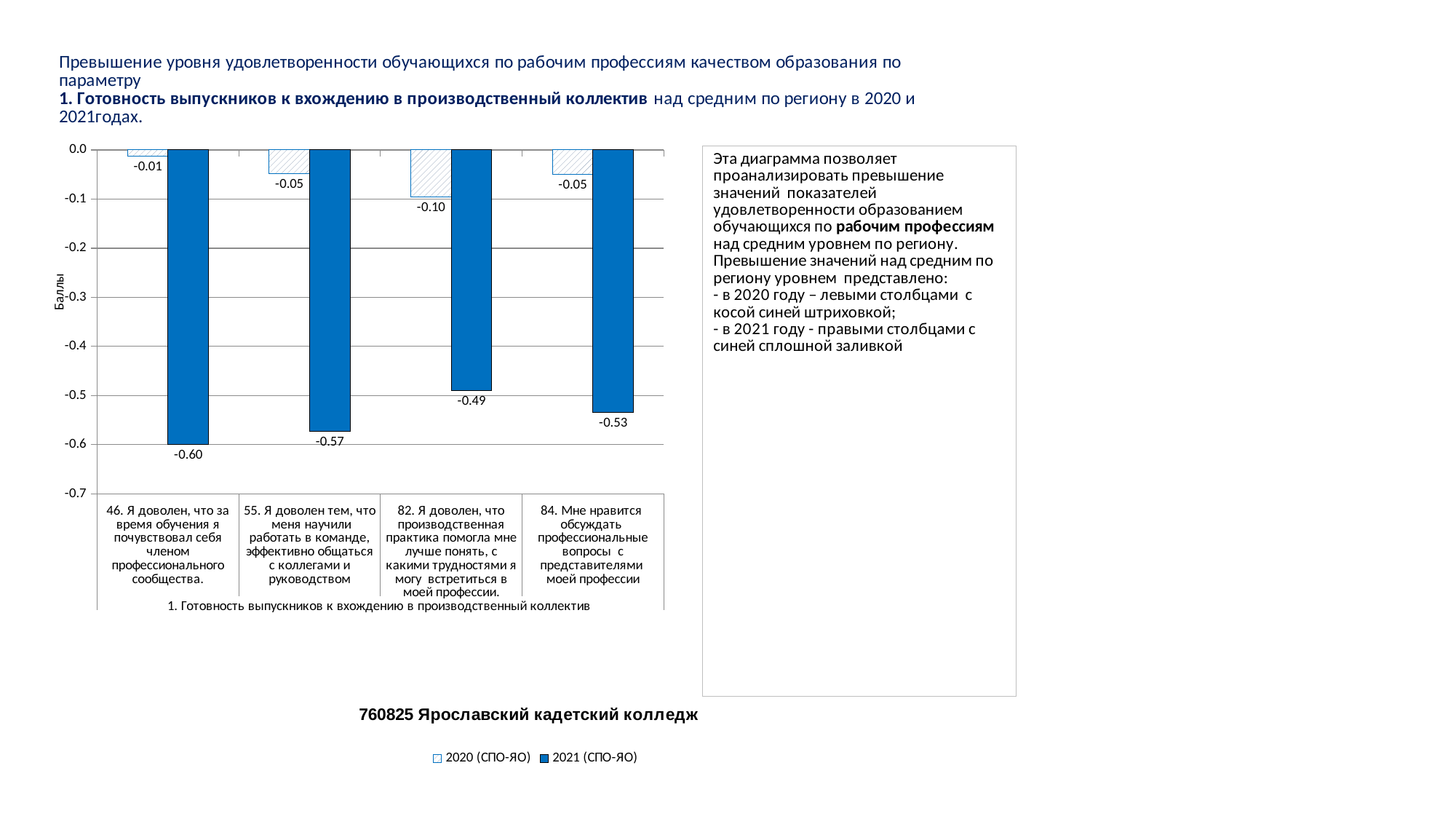
Which series is shown with blue diagonal hatching according to the legend? 2020 (СПО-ЯО) What is the 2020 (СПО-ЯО) value for category 82 ("Я доволен, что производственная практика помогла мне лучше понять...")? -0.10 What is the label of the vertical axis? Баллы How many series does the legend list? 2 What is the difference between the 2021 and 2020 values for category 55 ("Я доволен тем, что меня научили работать в команде...")? 0.52 What type of chart is shown on the slide? Bar chart Which is larger: the 2021 value for category 82 or the 2021 value for category 84? 2021 value for category 82 (-0.49) What is the 2021 (СПО-ЯО) value for category 84 ("Мне нравится обсуждать профессиональные вопросы с представителями моей профессии")? -0.53 Which category has the lowest 2020 (СПО-ЯО) value? 82. Я доволен, что производственная практика помогла мне лучше понять, с какими трудностями я могу встретиться в моей профессии. What is the 2021 (СПО-ЯО) value for category 46 ("Я доволен, что за время обучения я почувствовал себя членом профессионального сообщества")? -0.60 How many categories (questions) are shown on the x axis of the chart? 4 Which category has the lowest 2021 (СПО-ЯО) value? 46. Я доволен, что за время обучения я почувствовал себя членом профессионального сообщества.